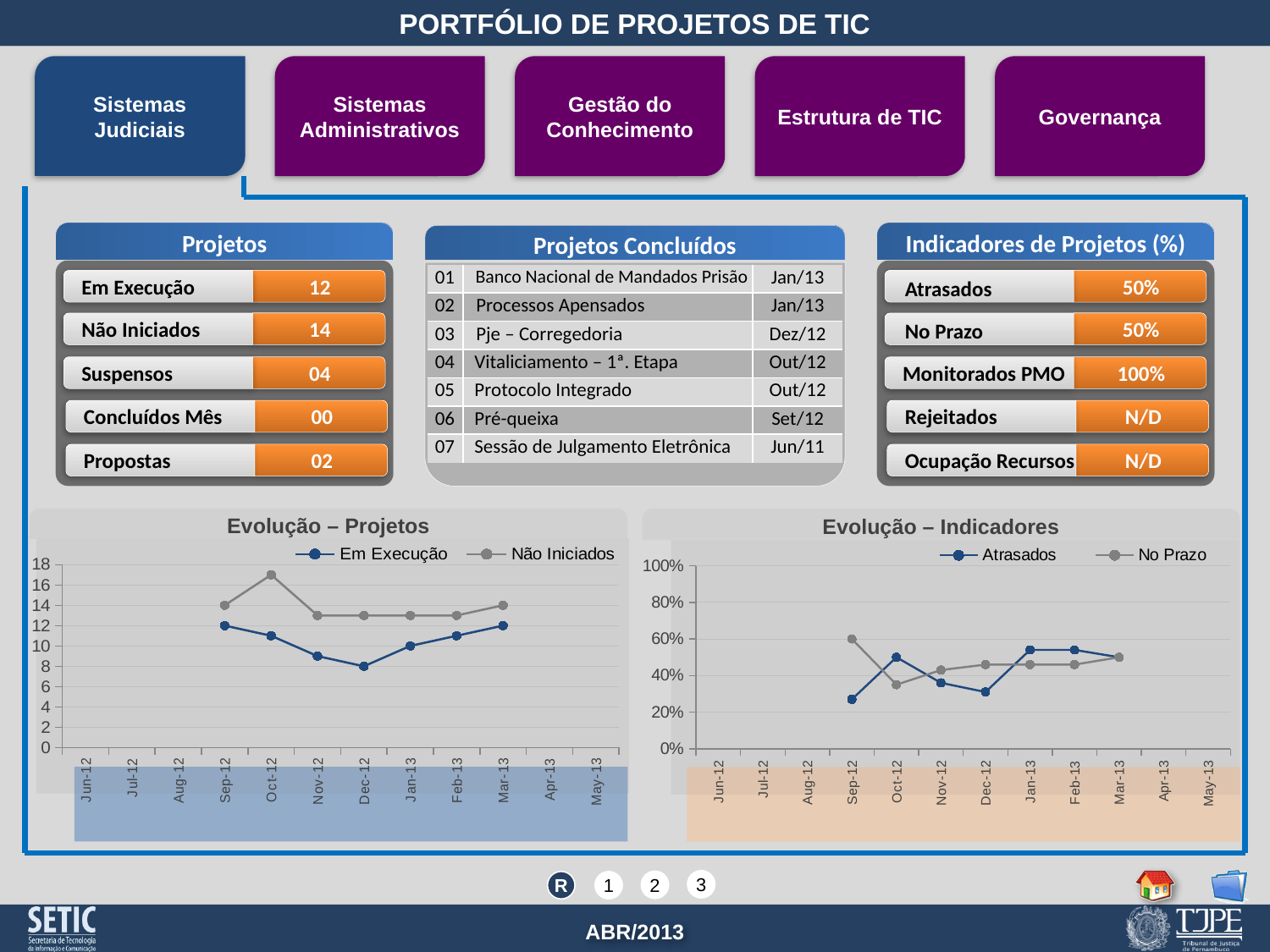
In 'Evolução – Indicadores', is the value of 'Atrasados' in Sep-12 greater or less than 40%? less In 'Evolução – Projetos', in which month does the 'Não Iniciados' series reach its highest value? Oct-12 In 'Evolução – Indicadores', in which month does the 'Atrasados' series reach its lowest value? Sep-12 In 'Evolução – Projetos', which series has the larger value in Sep-12, 'Em Execução' or 'Não Iniciados'? Não Iniciados In 'Evolução – Projetos', what is the value of 'Em Execução' in Dec-12? 8 In 'Evolução – Projetos', which series does the legend list besides 'Em Execução'? Não Iniciados How many series does the legend of 'Evolução – Indicadores' list? 2 In 'Evolução – Projetos', does the 'Em Execução' series rise or fall from Sep-12 to Dec-12? fall In 'Evolução – Indicadores', which series has the larger value in Sep-12, 'Atrasados' or 'No Prazo'? No Prazo In 'Evolução – Projetos', is the value of 'Não Iniciados' in Oct-12 greater or less than 16? greater In 'Evolução – Projetos', in which month does the 'Em Execução' series reach its lowest value? Dec-12 What kind of chart is 'Evolução – Projetos'? line chart